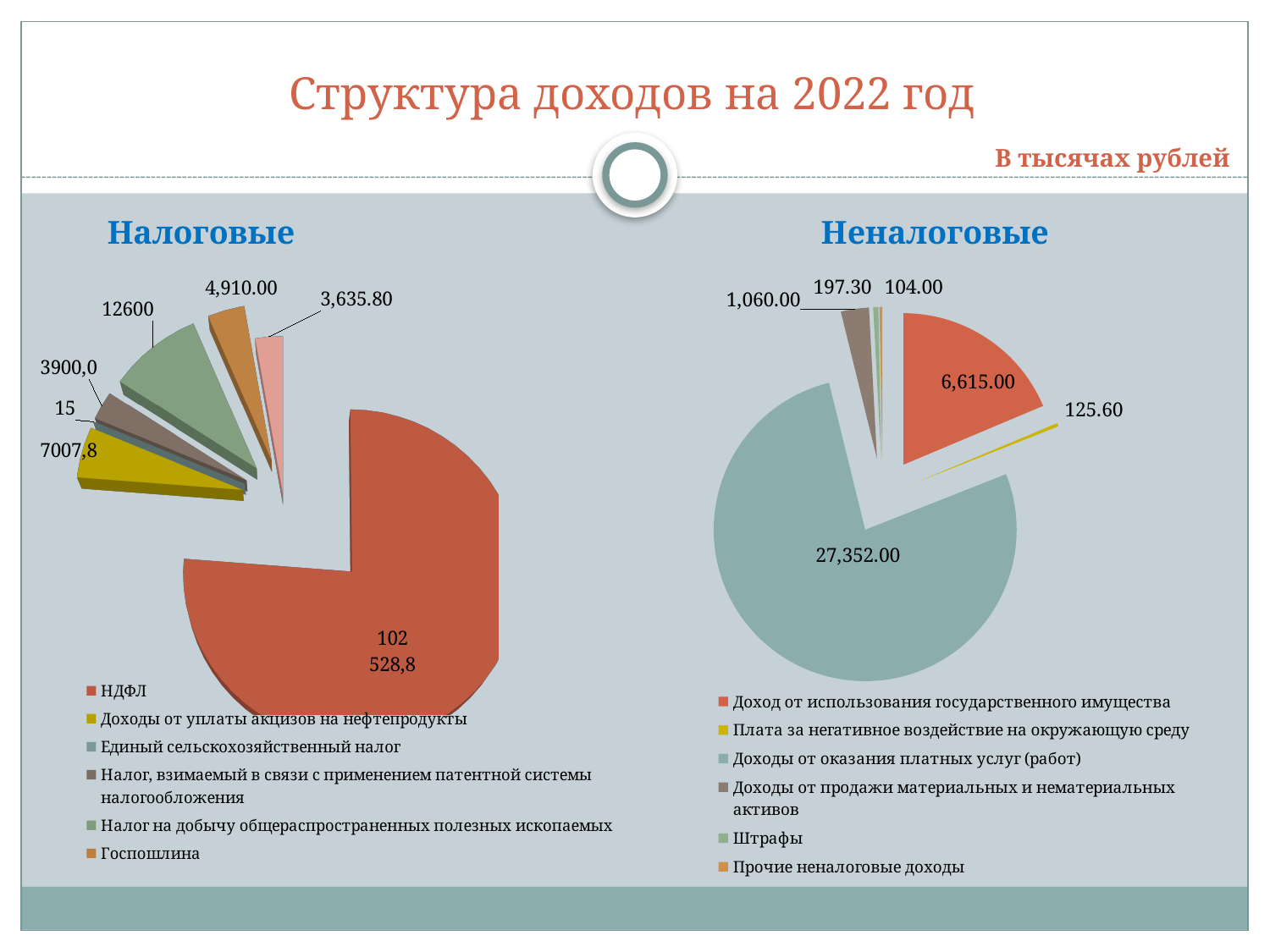
In the 'Налоговые' chart, which category has the smallest value? Единый сельскохозяйственный налог In the 'Налоговые' chart, what is the value for НДФЛ? 102 528,8 How many entries does the legend of the 'Налоговые' chart list? 6 In the 'Налоговые' chart, what is the value for Налог на добычу общераспространенных полезных ископаемых? 12600 In the 'Неналоговые' chart, which category has the largest value? Доходы от оказания платных услуг (работ) In the 'Неналоговые' chart, what is the value for Доходы от оказания платных услуг (работ)? 27,352.00 What type of chart is used for the 'Налоговые' chart on the left? pie chart In the 'Неналоговые' chart, what is the value for Штрафы? 197.30 In the 'Налоговые' chart, which is larger: Доходы от уплаты акцизов на нефтепродукты or Налог, взимаемый в связи с применением патентной системы налогообложения? Доходы от уплаты акцизов на нефтепродукты In the 'Неналоговые' chart, what is the difference between Доходы от оказания платных услуг (работ) and Доход от использования государственного имущества? 20,737.00 How many slices does the 'Неналоговые' chart have? 6 In the 'Налоговые' chart, what is the value for Госпошлина? 4,910.00